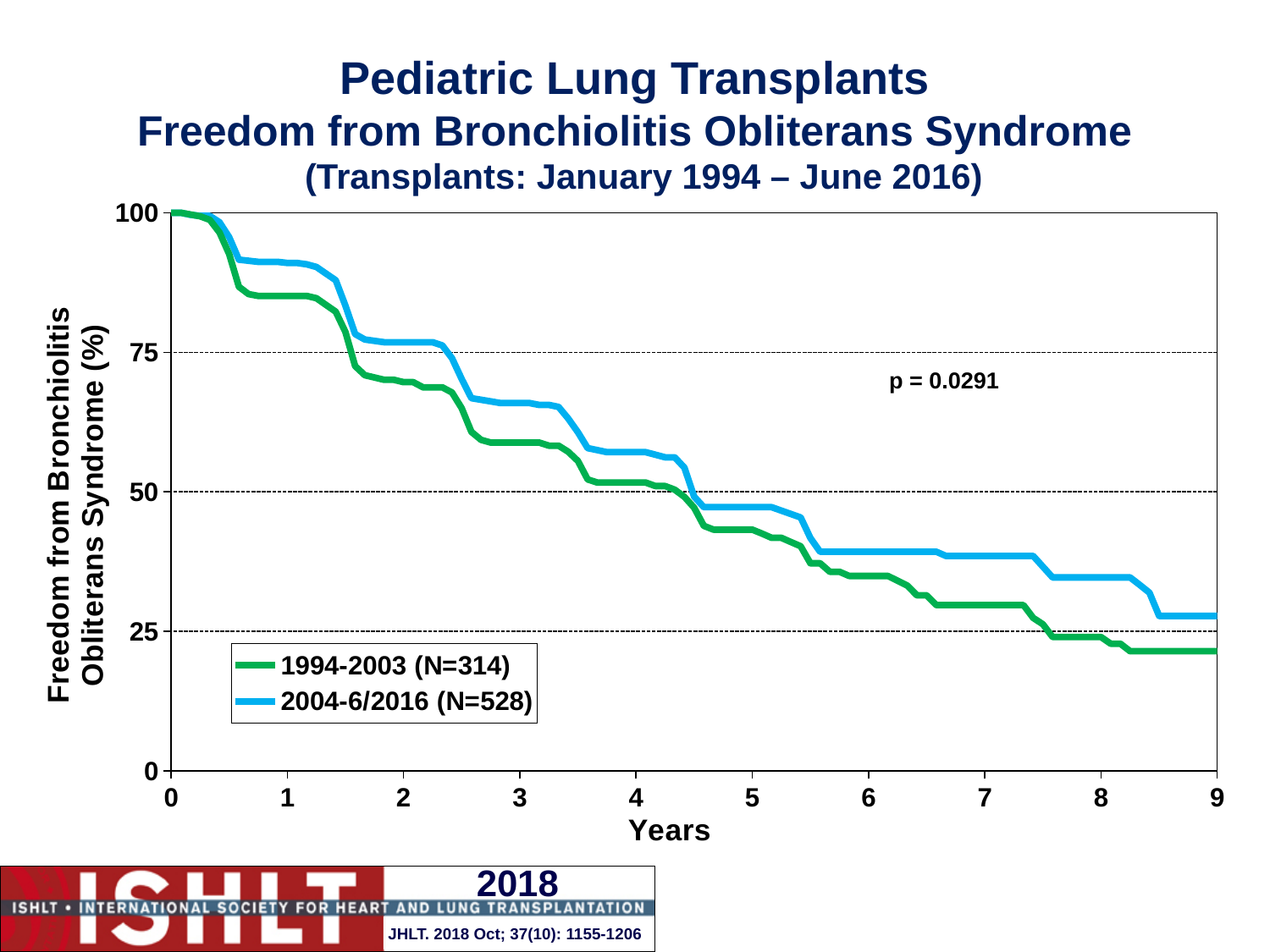
At 9 years, which series has the higher value, 1994-2003 or 2004-6/2016? 2004-6/2016 Do the values for the 1994-2003 series rise or fall as years increase? fall Is the value for the 2004-6/2016 series at 9 years greater or less than 25? greater At 5 years, which series has the higher freedom from bronchiolitis obliterans syndrome, 1994-2003 or 2004-6/2016? 2004-6/2016 Is the value for the 2004-6/2016 series at 1 year greater or less than 75? greater How many series does the legend list? 2 What kind of chart is shown on the slide? line chart Is the value for the 1994-2003 series at 9 years greater or less than 25? less What p-value is printed on the chart? p = 0.0291 What is the N for the 2004-6/2016 series shown in the legend? N=528